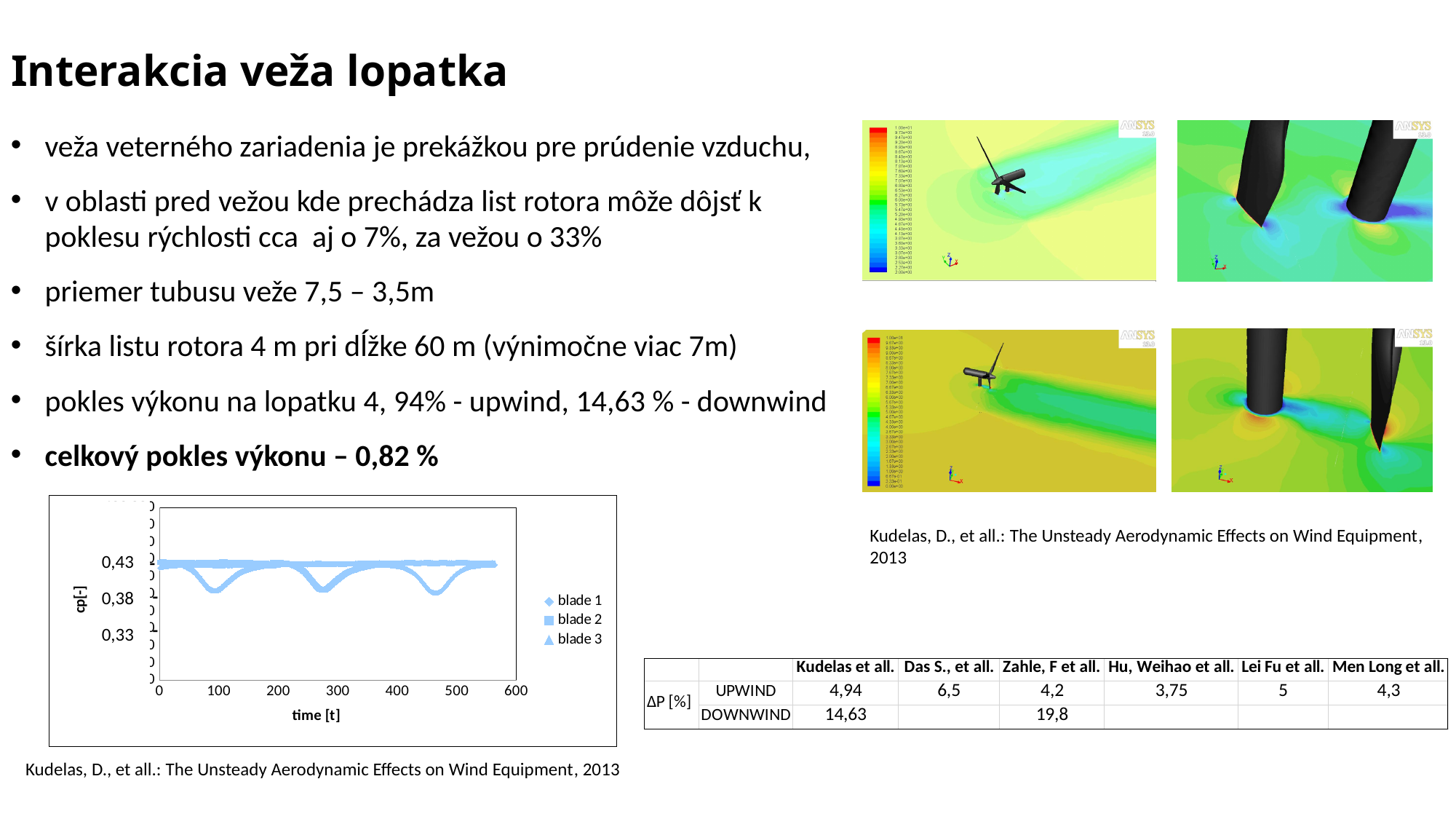
In the cp[-] vs time chart, is the lowest point of the dips greater or less than 0,33? greater What is the largest tick value shown on the time axis of the chart? 600 What is the x-axis label of the chart at the bottom left? time [t] How many dips in cp[-] are visible along the time axis in the chart? 3 How many series does the legend of the cp[-] vs time chart list? 3 Along the time axis, do the cp[-] values steadily rise, steadily fall, or stay roughly level with periodic dips? roughly level with periodic dips What kind of chart is shown at the bottom left of the slide? scatter chart In the cp[-] vs time chart, is the value at time 200 greater or less than 0,38? greater In the cp[-] vs time chart, is the value at time 0 greater or less than 0,38? greater What are the legend entries of the cp[-] vs time chart? blade 1, blade 2, blade 3